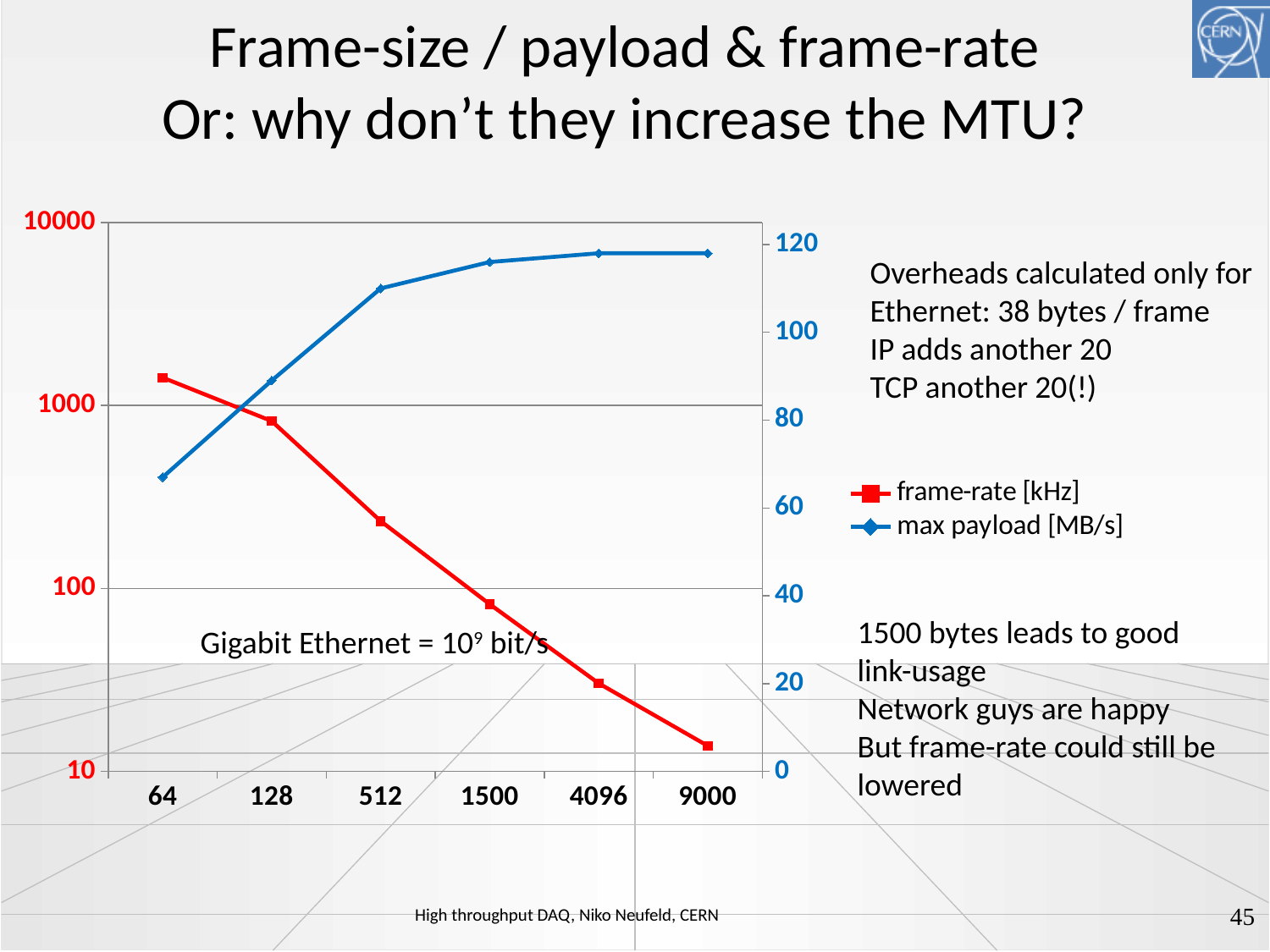
At which frame size is the frame-rate [kHz] lowest? 9000 Does the max payload [MB/s] series rise or fall as frame size increases along the x axis? rise How many series does the chart legend list? 2 Is the frame-rate [kHz] at frame size 1500 greater or less than 100? less At which frame size is the frame-rate [kHz] highest? 64 How many frame-size categories are plotted along the x axis? 6 Is the max payload [MB/s] at frame size 512 greater or less than 100? greater Which series is drawn in red on the chart? frame-rate [kHz] Is the frame-rate [kHz] at frame size 64 greater or less than 1000? greater At which frame size is the max payload [MB/s] lowest? 64 Does the frame-rate [kHz] series rise or fall as frame size increases along the x axis? fall What kind of chart is shown on the slide? line chart